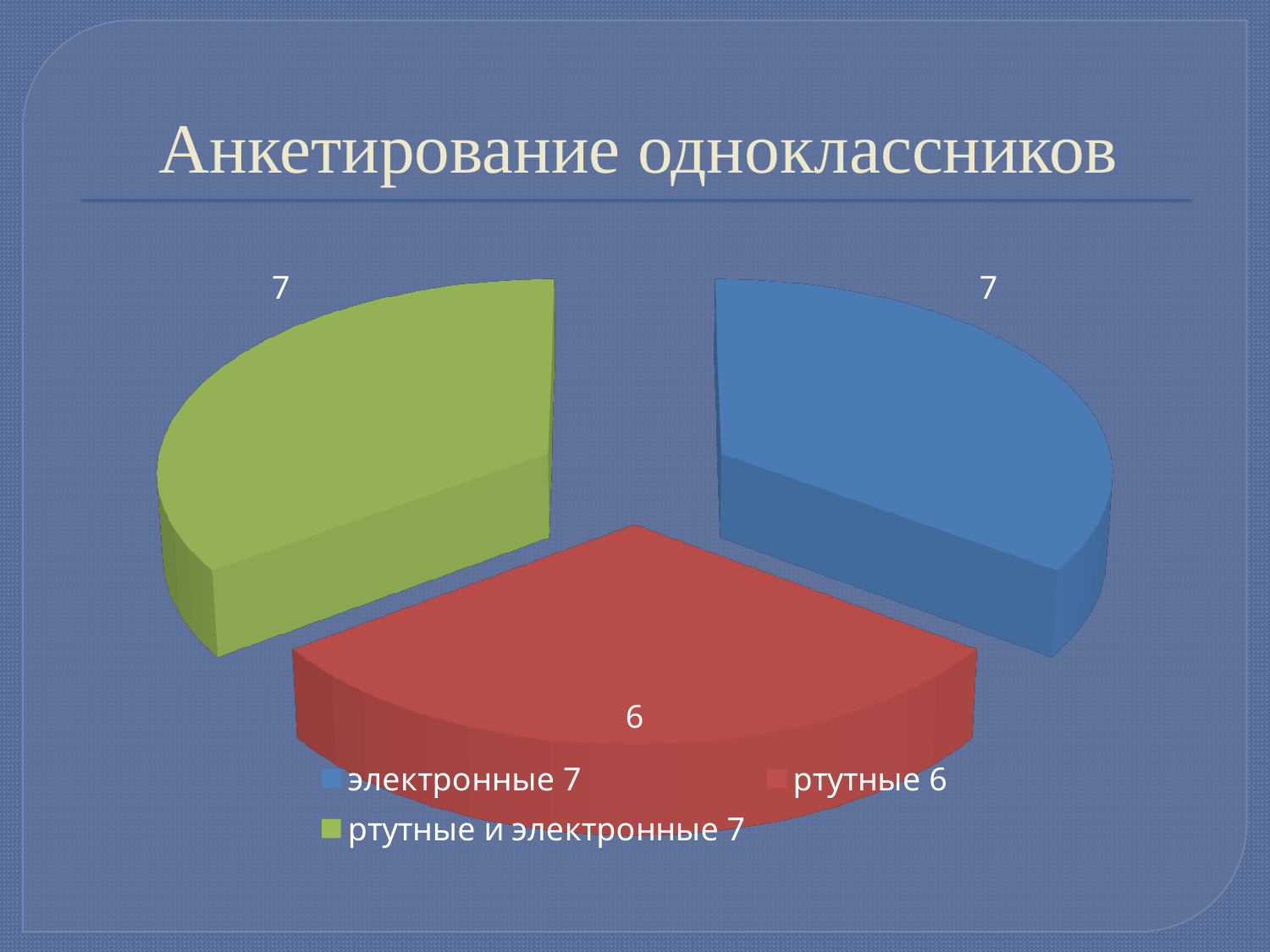
What is the difference between the values for "электронные" and "ртутные"? 1 What kind of chart is shown on the slide? pie chart What share of the pie does the "ртутные" slice represent? 30% How many entries does the legend list? 3 What is the value for the slice labelled "ртутные и электронные"? 7 Which is larger, the value for "электронные" or the value for "ртутные"? электронные Which slice has the lowest value? ртутные What is the total of all slices in the pie chart? 20 What is the value for the slice labelled "ртутные"? 6 What is the title of the slide containing the chart? Анкетирование одноклассников How many slices does the pie chart have? 3 What is the value for the slice labelled "электронные"? 7